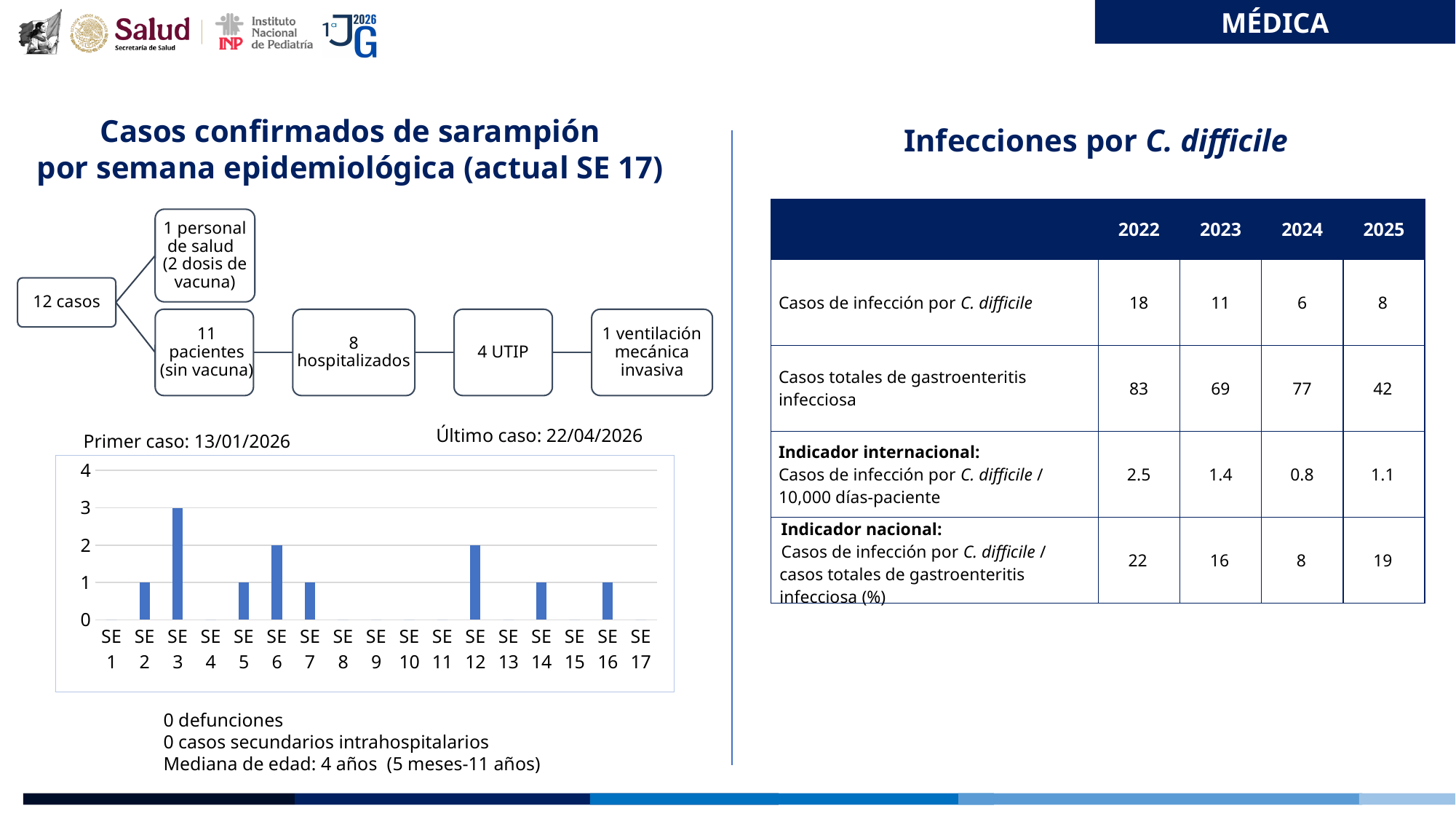
Which epidemiological week has the highest number of confirmed measles cases in the bar chart? SE 3 Is the value for SE 3 in the bar chart greater or less than 2? greater What is the difference between the number of cases in SE 3 and SE 6 in the bar chart? 1 How many confirmed measles cases are shown for SE 3 in the bar chart? 3 How many confirmed measles cases are shown for SE 2 in the bar chart? 1 What is the highest value shown on the y axis of the bar chart? 4 How many confirmed measles cases are shown for SE 10 in the bar chart? 0 How many epidemiological weeks (categories) are shown on the x axis of the bar chart? 17 What kind of chart is shown on the slide? bar chart How many confirmed measles cases are shown for SE 12 in the bar chart? 2 Which has more confirmed measles cases in the bar chart, SE 3 or SE 6? SE 3 How many confirmed measles cases are shown for SE 6 in the bar chart? 2